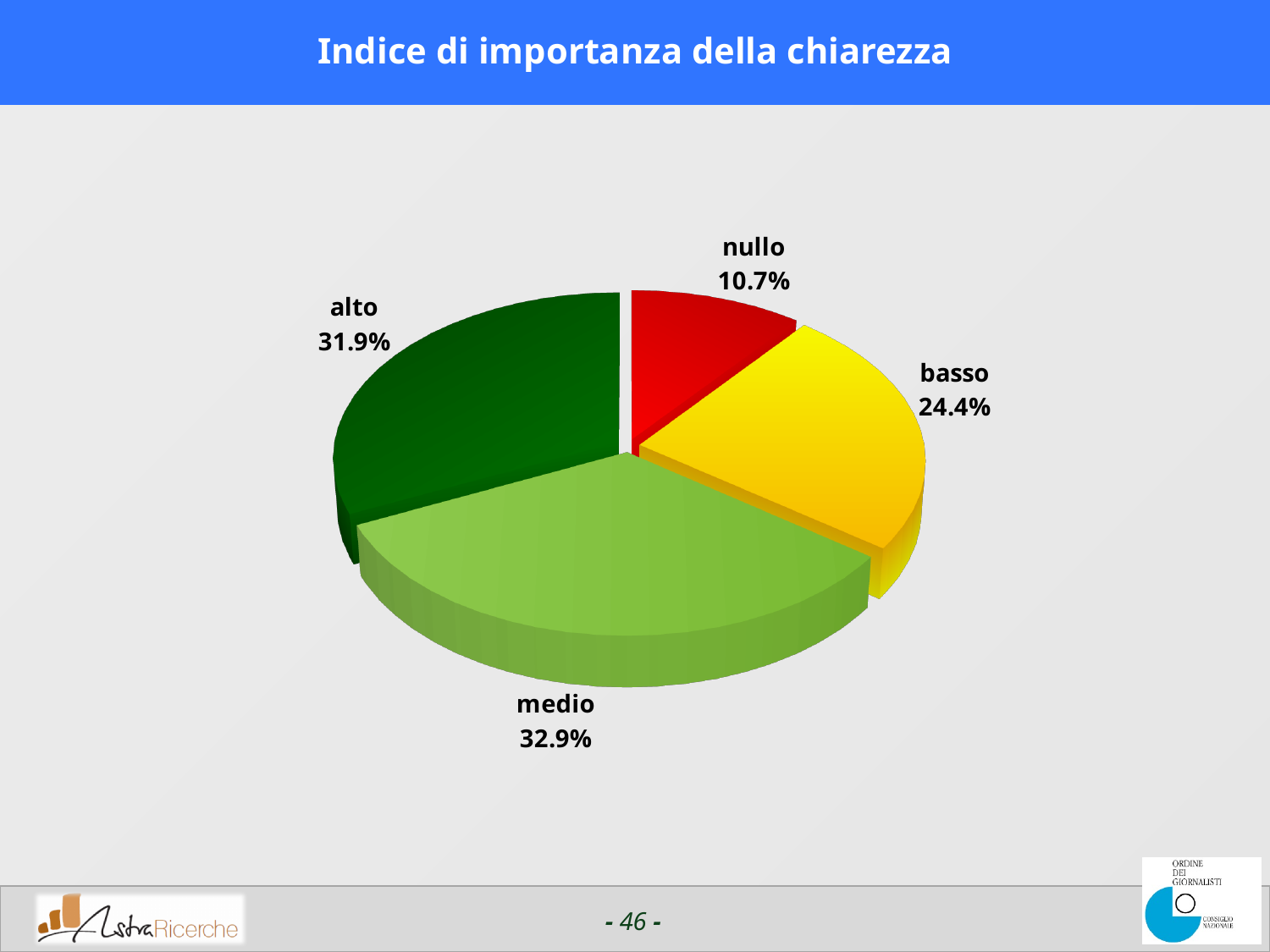
What is the title of the chart? Indice di importanza della chiarezza What percentage is shown for the 'medio' slice? 32.9% How many slices does the pie chart have? 4 What percentage is shown for the 'nullo' slice? 10.7% Which category has the smallest share of the pie? nullo Which is larger, the share for 'basso' or the share for 'nullo'? basso Which category has the largest share of the pie? medio What colour is the 'nullo' slice? red What percentage is shown for the 'basso' slice? 24.4% What is the difference in percentage points between the 'basso' and 'nullo' slices? 13.7 What percentage is shown for the 'alto' slice? 31.9% What kind of chart is shown on the slide? pie chart